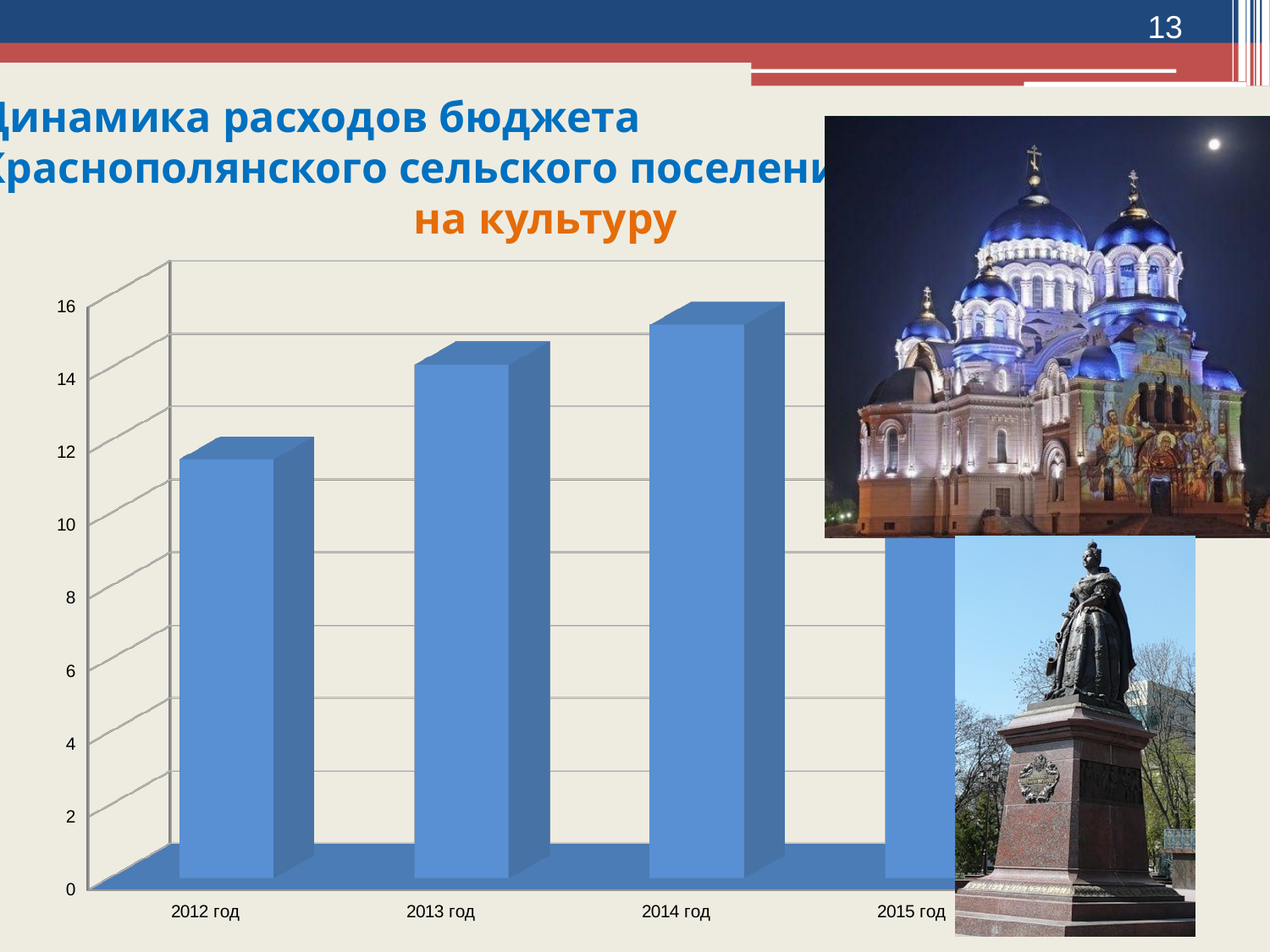
Is the value for 2012 год greater or less than 12? less Do the values rise or fall from 2012 год to 2014 год? rise Which is larger, the value for 2012 год or the value for 2014 год? 2014 год What is the highest tick value shown on the vertical axis of the chart? 16 Is the value for 2013 год greater or less than 12? greater What kind of chart is shown on the slide? bar chart Is the value for 2014 год greater or less than 16? less How many years (categories) are shown on the x axis of the chart? 4 Which is larger, the value for 2012 год or the value for 2013 год? 2013 год Which is larger, the value for 2013 год or the value for 2014 год? 2014 год